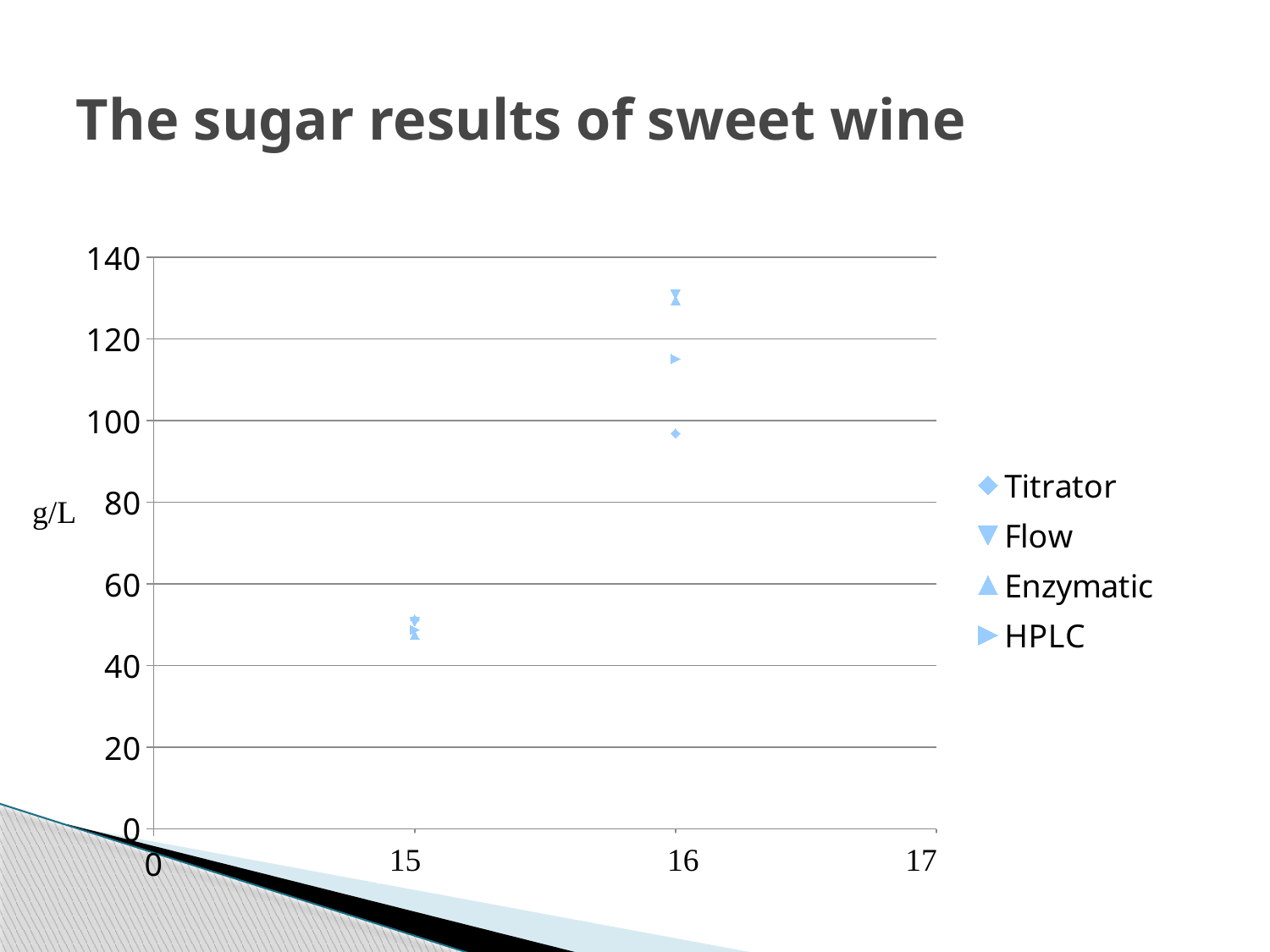
Is the HPLC value at x = 16 greater or less than 100? greater Is the HPLC value at x = 15 greater or less than 40? greater What is the title of the chart? The sugar results of sweet wine Which series are listed in the legend? Titrator, Flow, Enzymatic, HPLC What kind of chart is shown on the slide? scatter chart At x = 16, which series has the lowest value? Titrator What unit is shown on the y axis? g/L Is the Titrator value at x = 16 greater or less than 100? less At x = 16, which is larger, the HPLC value or the Titrator value? HPLC How many series does the legend list? 4